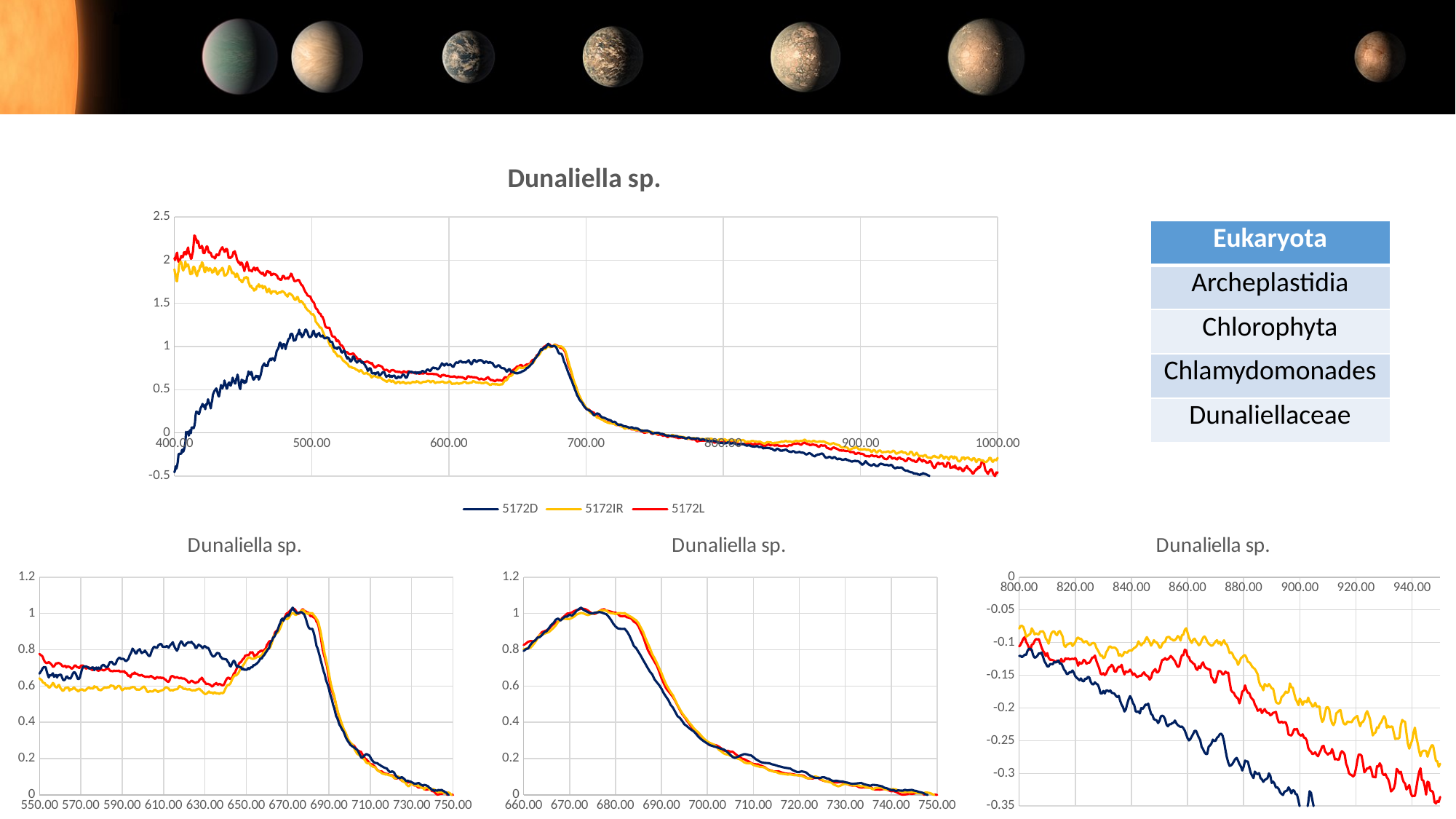
In the bottom-right chart, is the value of the yellow line at 940.00 greater or less than -0.2? less In the top chart, is the value of 5172D at 400.00 greater or less than 0? less How many series does the legend of the top chart list? 3 In the bottom-left chart, is the value of the dark blue line at 610.00 greater or less than 0.6? greater How many charts are shown on the slide? 4 What kind of chart is the large top chart titled "Dunaliella sp."? line chart In the top chart, which series has the higher value at 400.00, 5172L or 5172D? 5172L What are the series names in the legend of the top chart? 5172D, 5172IR, 5172L In the top chart, does the 5172L series rise or fall between 700.00 and 1000.00? fall In the bottom-right chart, does the dark blue line rise or fall from 800.00 to 900.00? fall